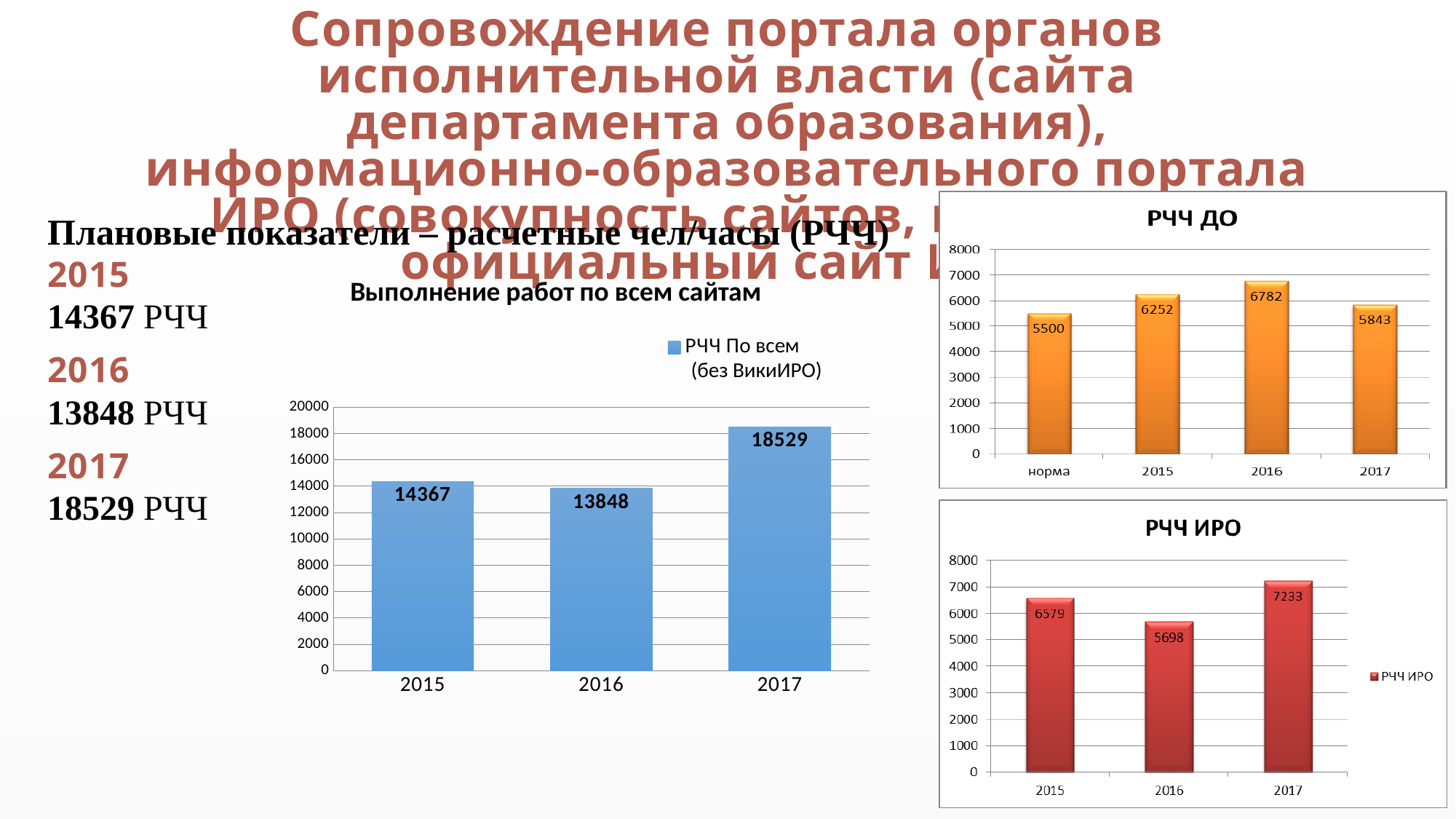
In the chart titled 'РЧЧ ДО', which category has the highest value? 2016 In the chart titled 'РЧЧ ИРО', what kind of chart is shown? bar chart In the chart titled 'РЧЧ ДО', how many categories are shown on the x axis? 4 In the chart titled 'РЧЧ ИРО', which is larger, the value for 2015 or the value for 2017? 2017 In the chart titled 'Выполнение работ по всем сайтам', what is the value for 2017? 18529 In the chart titled 'РЧЧ ДО', what is the value for 'норма'? 5500 In the chart titled 'РЧЧ ДО', what is the difference between the 2015 value and the 'норма' value? 752 In the chart titled 'Выполнение работ по всем сайтам', how many bars are plotted? 3 In the chart titled 'РЧЧ ИРО', what is the value for 2016? 5698 In the chart titled 'Выполнение работ по всем сайтам', what is the difference between the 2017 and 2016 values? 4681 In the chart titled 'Выполнение работ по всем сайтам', what series name does the legend show? РЧЧ По всем (без ВикиИРО) In the chart titled 'Выполнение работ по всем сайтам', which year has the lowest value? 2016